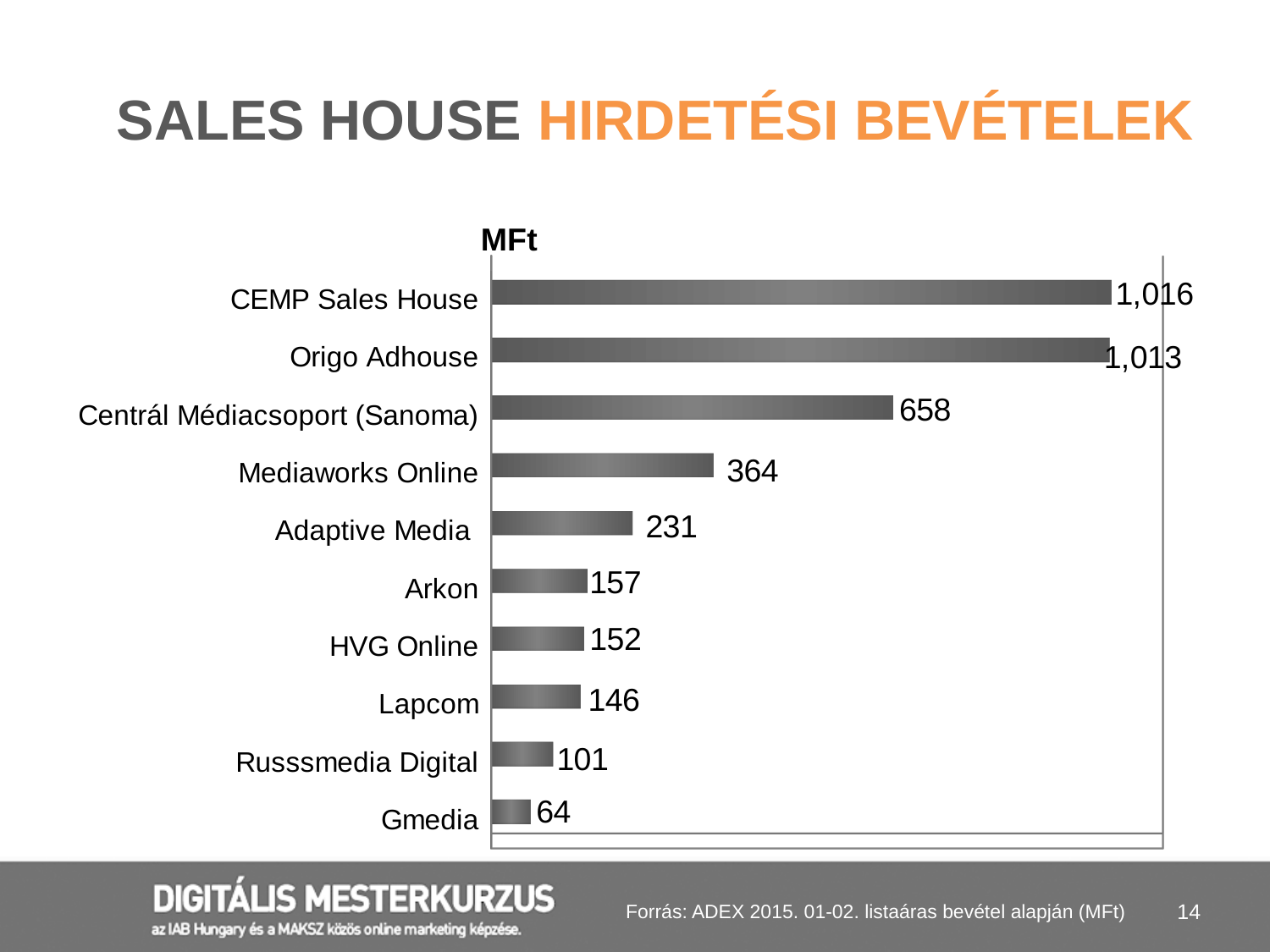
Which has a larger value, Gmedia or Russsmedia Digital? Russsmedia Digital What is the value for CEMP Sales House? 1,016 What is the difference between the values for Arkon and HVG Online? 5 What is the difference between the values for Centrál Médiacsoport (Sanoma) and Mediaworks Online? 294 What is the value for Mediaworks Online? 364 How many sales houses are shown in the chart? 10 What unit is shown above the chart? MFt What kind of chart is shown on the slide? Bar chart Which sales house has the lowest value? Gmedia What is the value for Russsmedia Digital? 101 Which has a larger value, Adaptive Media or Lapcom? Adaptive Media What is the value for Centrál Médiacsoport (Sanoma)? 658